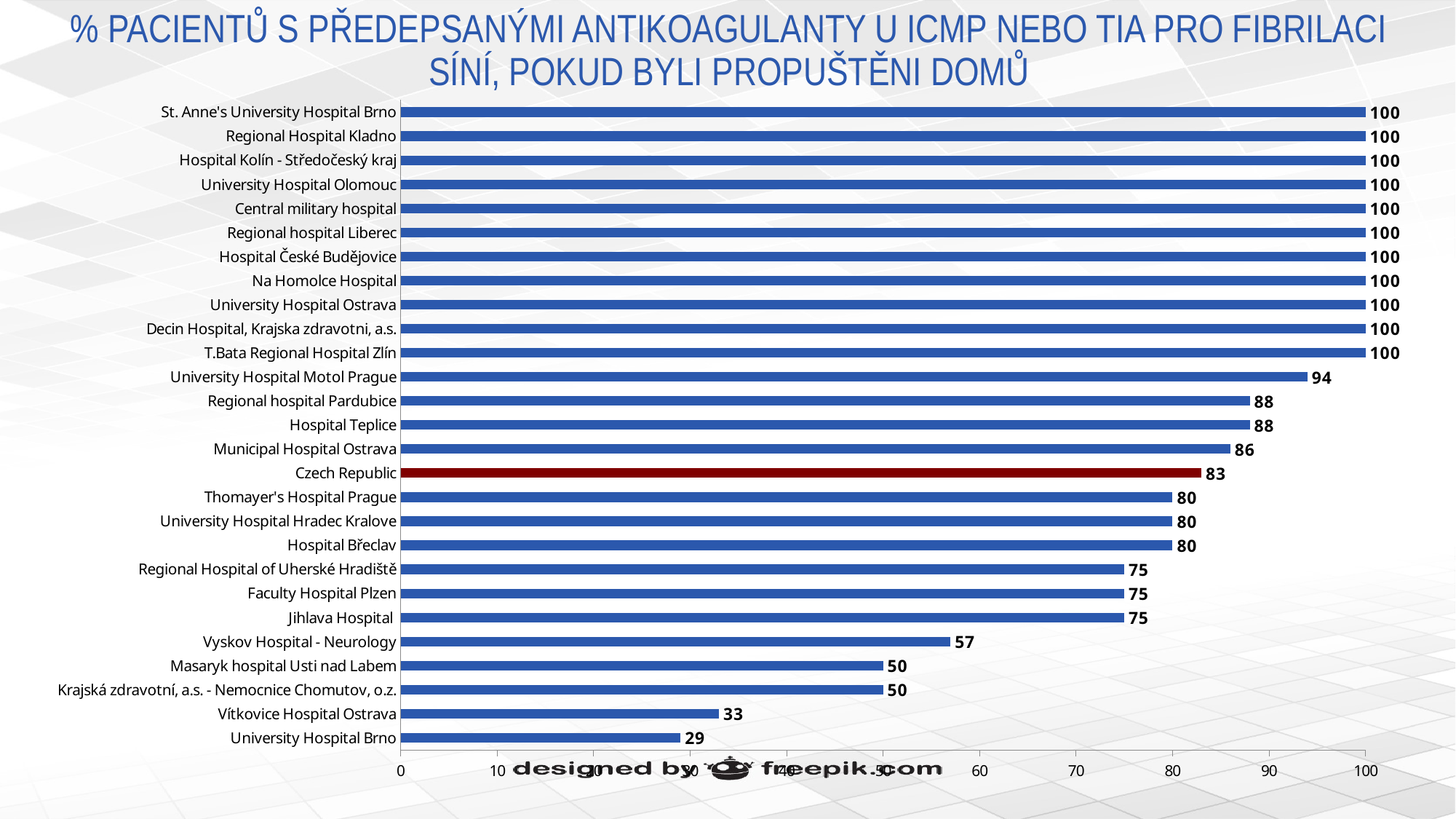
Which bar is shown in a different colour (dark red) from the others? Czech Republic What is the value for Vyskov Hospital - Neurology? 57 What is the difference between the values for University Hospital Motol Prague and University Hospital Brno? 65 Which category has the lowest value? University Hospital Brno How many categories have a value of 100? 11 What is the value for Vítkovice Hospital Ostrava? 33 Which is larger, the value for Hospital Teplice or the value for Hospital Břeclav? Hospital Teplice How many categories are shown on the chart? 27 What kind of chart is shown on the slide? bar chart What is the value for Czech Republic? 83 What is the difference between the values for Municipal Hospital Ostrava and Czech Republic? 3 What is the value for University Hospital Motol Prague? 94